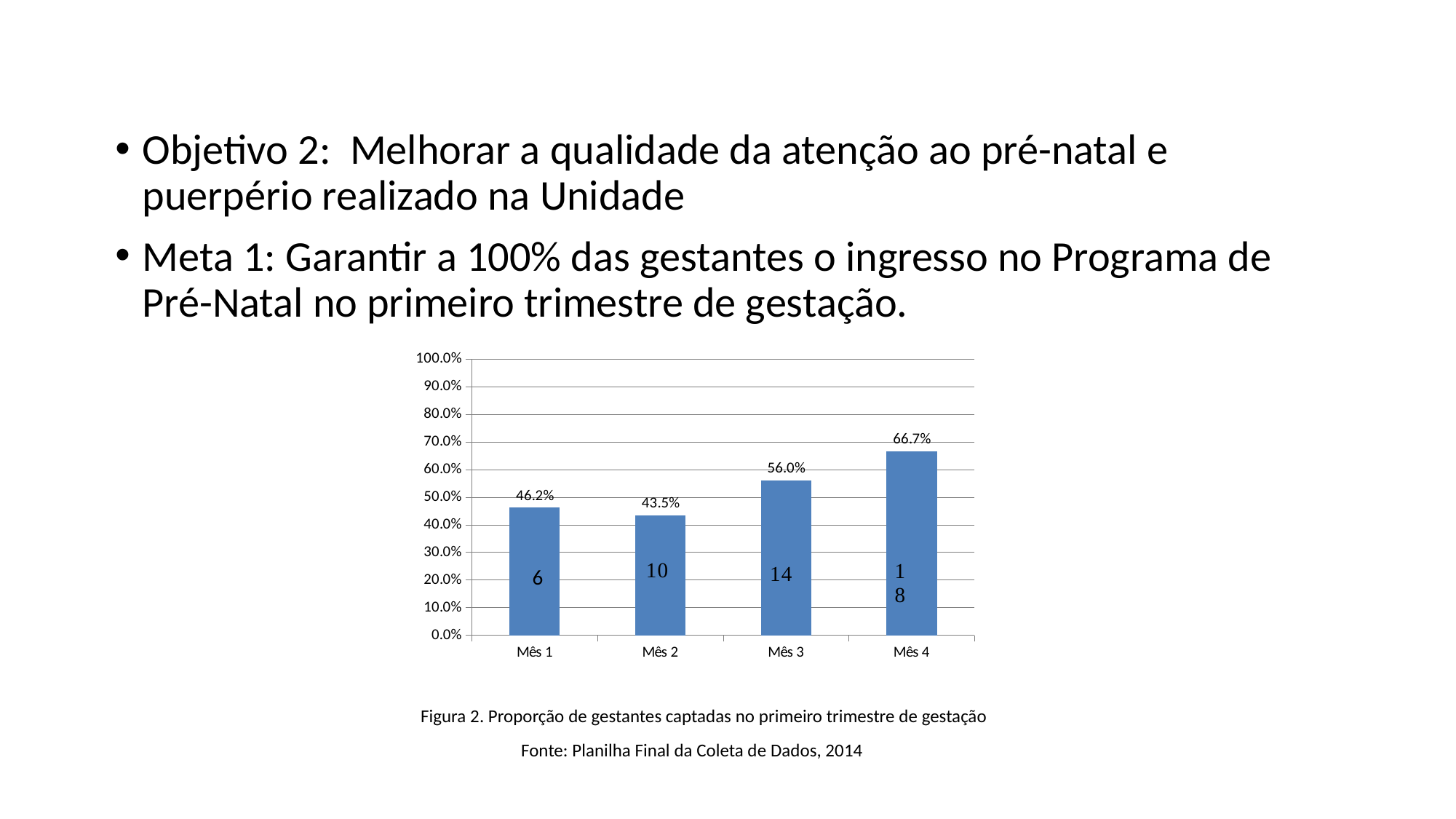
Which month has the lowest value? Mês 2 Which is larger, the value for Mês 3 or the value for Mês 2? Mês 3 How many months are shown on the x axis? 4 What is the value for Mês 4? 66.7% Which month has the highest value? Mês 4 What is the value for Mês 3? 56.0% What is the caption of the figure below the chart? Figura 2. Proporção de gestantes captadas no primeiro trimestre de gestação What is the value for Mês 2? 43.5% Is the value for Mês 4 greater or less than 60.0%? greater What is the difference between the values for Mês 4 and Mês 1? 20.5% What is the value for Mês 1? 46.2% What kind of chart is shown on the slide? bar chart